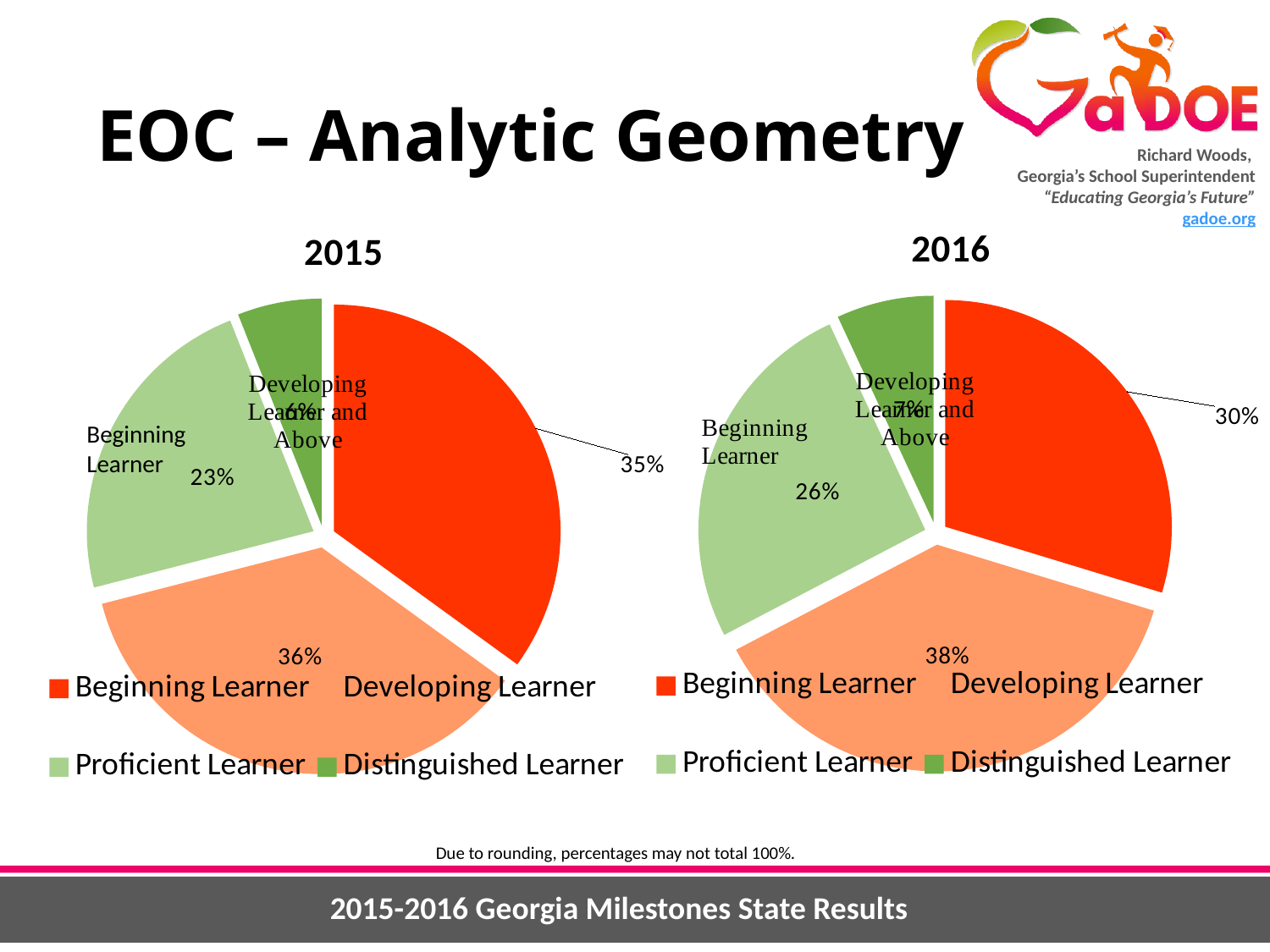
In the 2016 pie chart, which category has the largest share? Developing Learner What type of chart is used for the 2015 results? Pie chart Which is larger: the Proficient Learner share in 2015 or in 2016? 2016 In the 2016 pie chart, what percentage is shown for Developing Learner? 38% In the 2015 pie chart, what percentage is shown for Proficient Learner? 23% In the 2015 pie chart, what percentage is shown for Developing Learner? 36% In the 2015 pie chart, which category has the smallest share? Distinguished Learner In the 2015 pie chart, what percentage is shown for Beginning Learner? 35% In the 2016 pie chart, what percentage is shown for Beginning Learner? 30% What is the difference between the Beginning Learner percentage in 2015 and in 2016? 5% In the 2016 pie chart, what percentage is shown for Proficient Learner? 26% How many categories does the legend of the 2016 pie chart list? 4